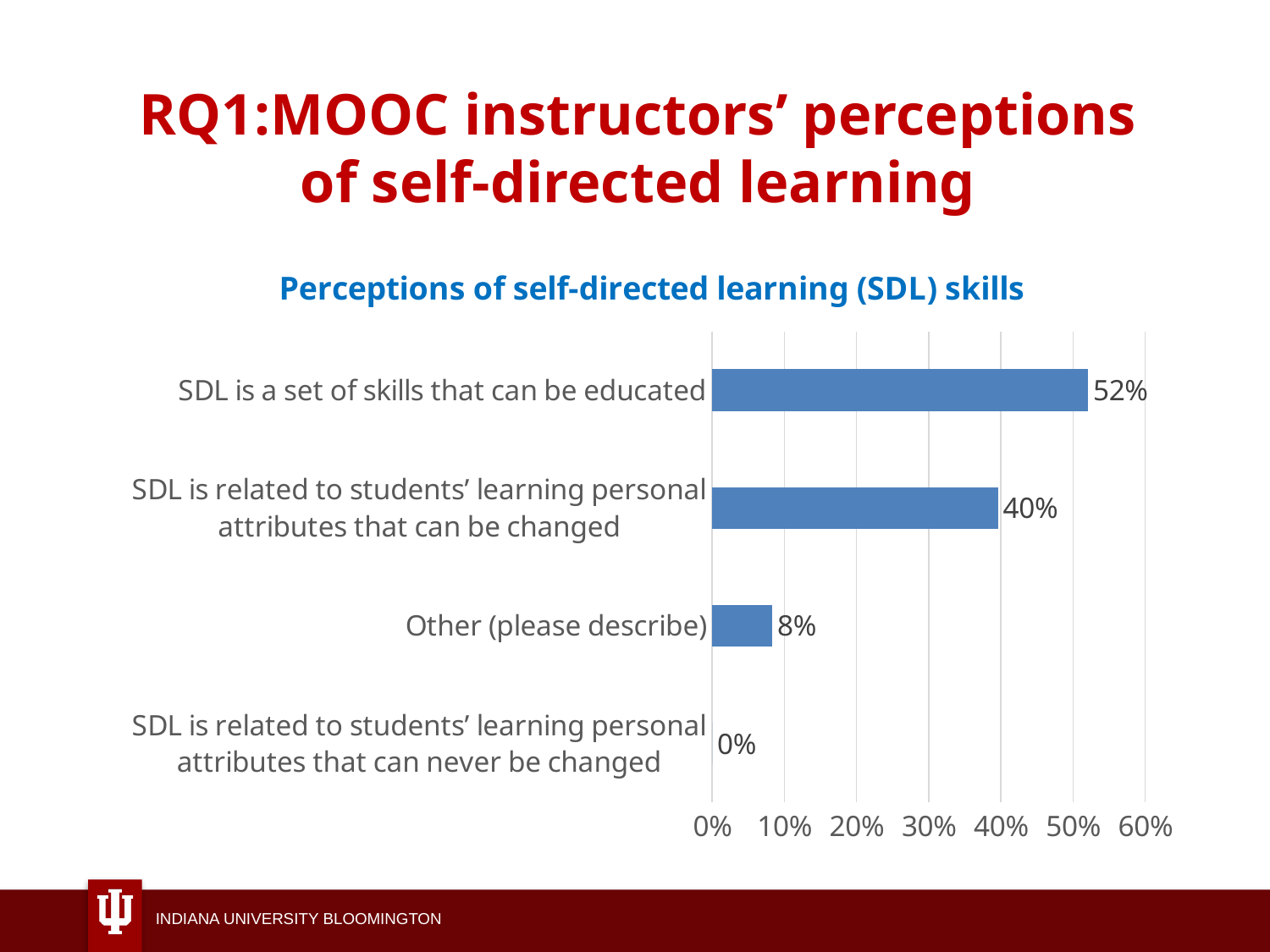
How many categories are shown in the chart? 4 What is the value for "Other (please describe)"? 8% What is the title of the chart? Perceptions of self-directed learning (SDL) skills Which category has the highest value? SDL is a set of skills that can be educated Which category has the lowest value? SDL is related to students' learning personal attributes that can never be changed Is the value for "SDL is a set of skills that can be educated" greater or less than 50%? greater What is the value for "SDL is related to students' learning personal attributes that can never be changed"? 0% What is the value for "SDL is a set of skills that can be educated"? 52% Which is larger: the value for "Other (please describe)" or the value for "SDL is related to students' learning personal attributes that can be changed"? SDL is related to students' learning personal attributes that can be changed What is the value for "SDL is related to students' learning personal attributes that can be changed"? 40% What is the difference between the values for "SDL is a set of skills that can be educated" and "SDL is related to students' learning personal attributes that can be changed"? 12% What kind of chart is shown on the slide? bar chart